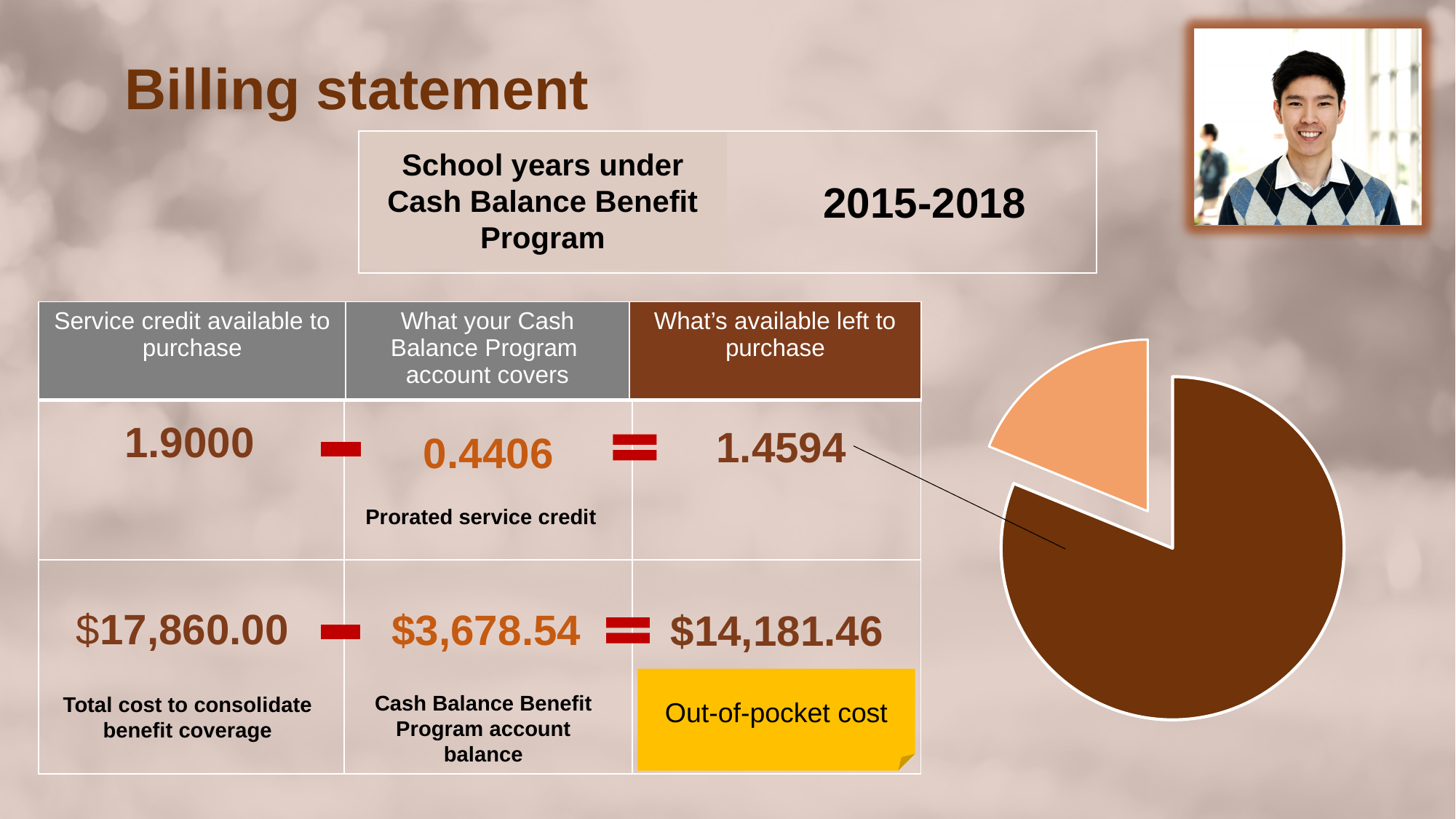
How many slices does the pie chart have? 2 Which slice of the pie chart is the smallest? the light orange slice Which slice of the pie chart is the largest? the dark brown slice Which slice of the pie chart is pulled out (exploded) from the rest of the pie? the light orange slice Which slice of the pie chart is larger, the dark brown slice or the light orange slice? the dark brown slice Which value in the table is connected by a line to the dark brown slice of the pie chart? 1.4594 What kind of chart is shown on the right side of the slide? pie chart Does the pie chart have a legend? No